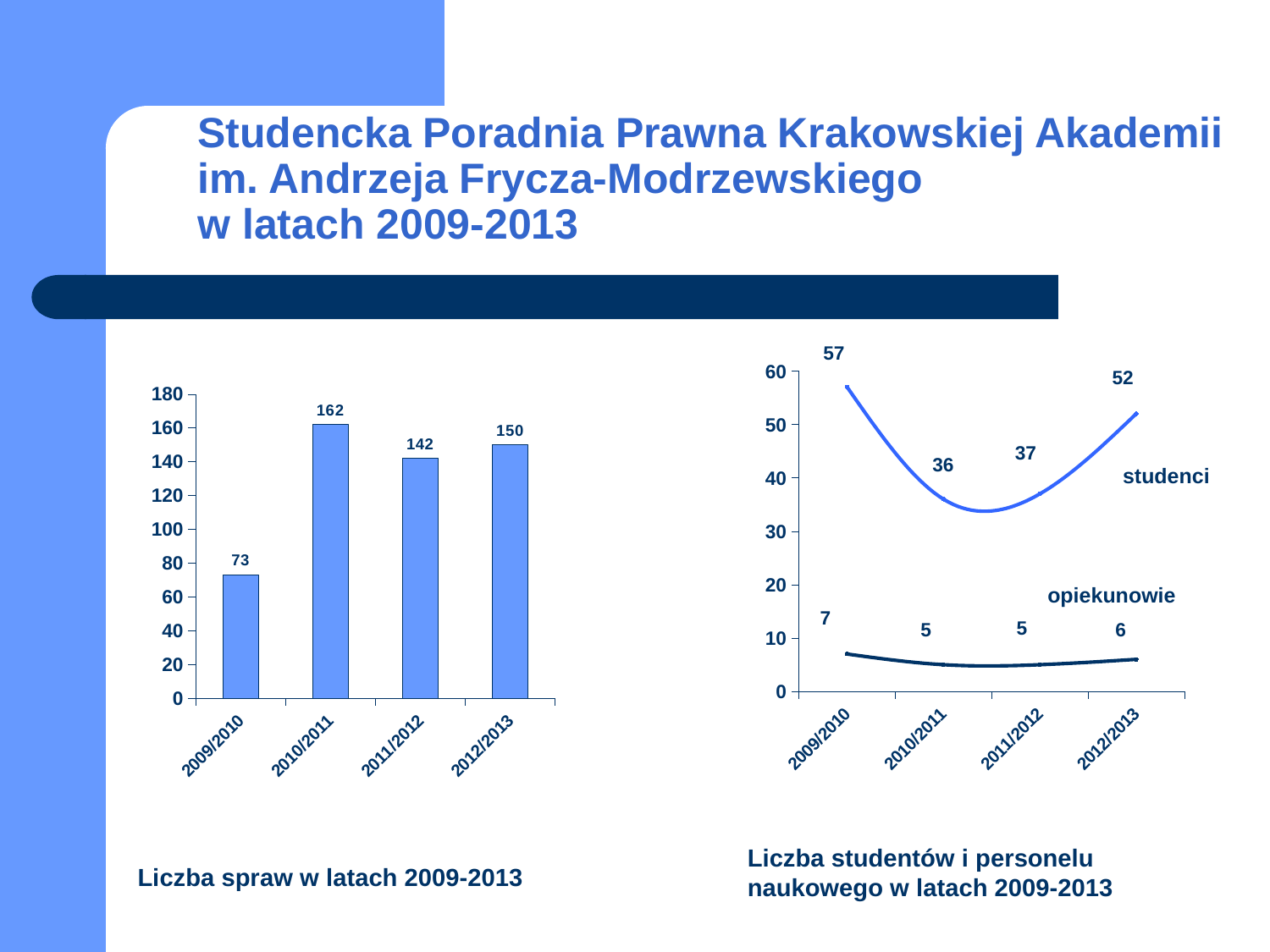
In the left chart (Liczba spraw w latach 2009-2013), how many bars are there? 4 In the right chart (Liczba studentów i personelu naukowego), what is the value for opiekunowie in 2009/2010? 7 In the right chart (Liczba studentów i personelu naukowego), what is the difference between studenci and opiekunowie in 2012/2013? 46 In the right chart (Liczba studentów i personelu naukowego), what is the value for studenci in 2011/2012? 37 In the left chart (Liczba spraw w latach 2009-2013), what is the value for 2010/2011? 162 What kind of chart is the right chart (Liczba studentów i personelu naukowego)? line chart In the right chart (Liczba studentów i personelu naukowego), in which year is the studenci value lowest? 2010/2011 In the left chart (Liczba spraw w latach 2009-2013), what is the difference between the values for 2010/2011 and 2009/2010? 89 What kind of chart is the left chart (Liczba spraw w latach 2009-2013)? bar chart In the left chart (Liczba spraw w latach 2009-2013), which is larger, the value for 2011/2012 or 2012/2013? 2012/2013 In the left chart (Liczba spraw w latach 2009-2013), which year has the lowest value? 2009/2010 In the left chart (Liczba spraw w latach 2009-2013), which year has the highest value? 2010/2011